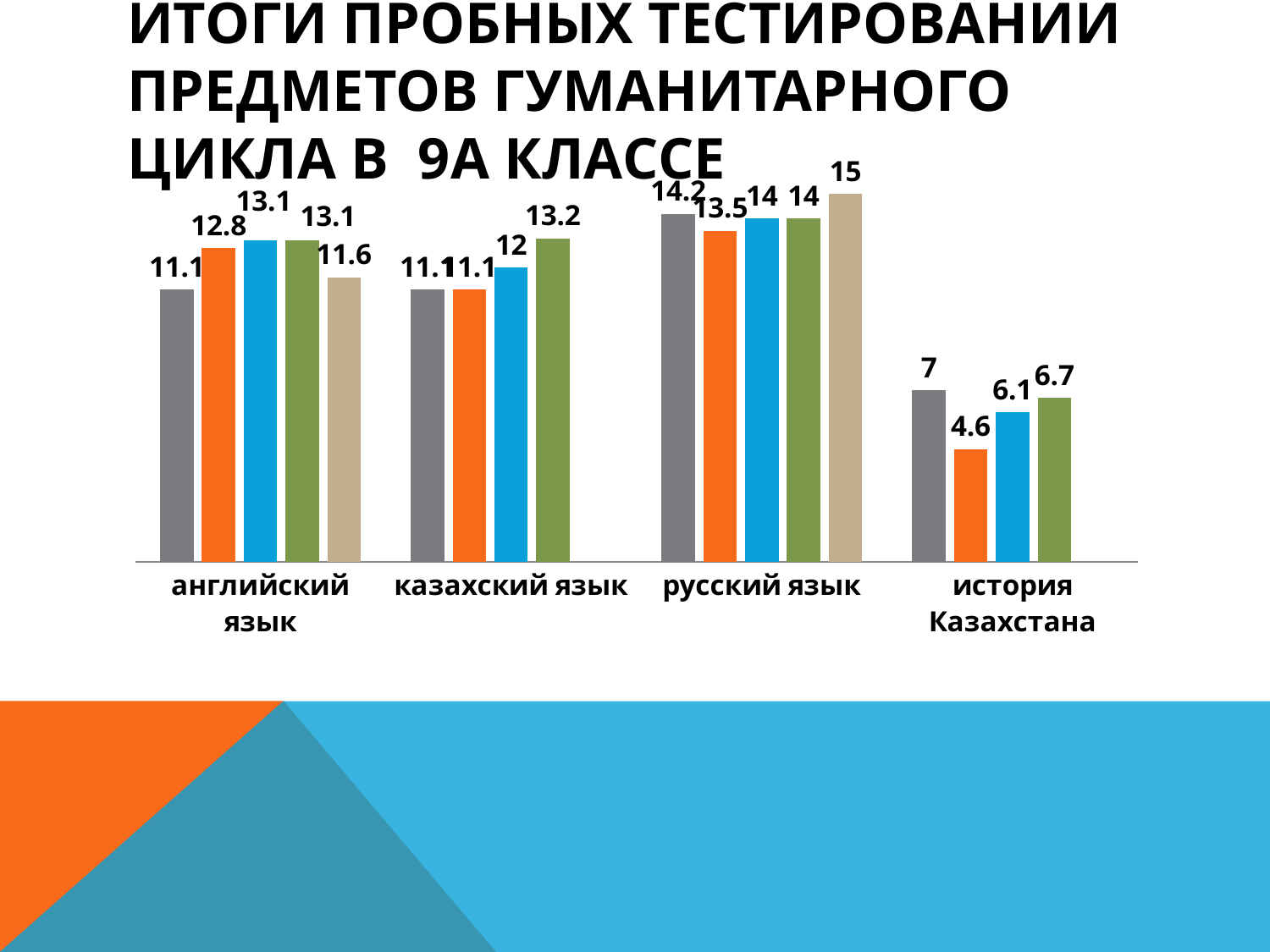
What is the difference between the grey bar and the orange bar for история Казахстана? 2.4 Which is larger: the green bar for казахский язык or the green bar for английский язык? казахский язык How many categories are shown on the x axis? 4 What is the difference between the tan bar and the orange bar for русский язык? 1.5 What is the value of the orange bar for история Казахстана? 4.6 What is the value of the grey bar for английский язык? 11.1 How many bars are shown for история Казахстана? 4 What is the value of the tan (beige) bar for русский язык? 15 What is the value of the blue bar for казахский язык? 12 Which category has the lowest bar on the chart? история Казахстана What kind of chart is shown on the slide? bar chart Which category has the highest bar on the chart? русский язык